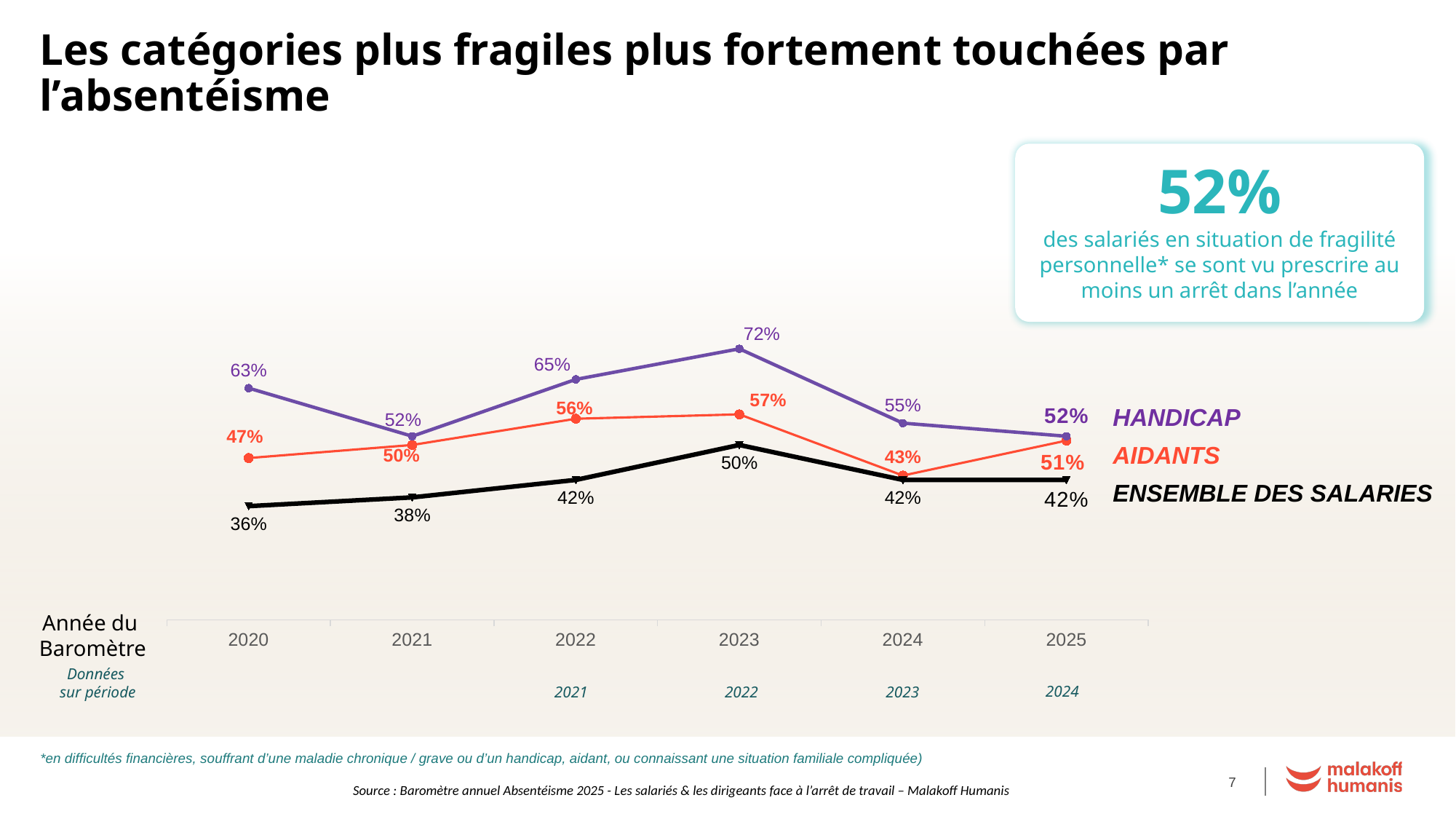
What is the value for AIDANTS in 2020? 47% Which is larger in 2021: the HANDICAP value or the AIDANTS value? HANDICAP How many years are shown on the x axis of the chart? 6 What is the difference between the HANDICAP value and the ENSEMBLE DES SALARIES value in 2023? 22 percentage points What is the value for ENSEMBLE DES SALARIES in 2023? 50% What is the value for HANDICAP in 2023? 72% How many series are plotted on the chart? 3 In which year is the ENSEMBLE DES SALARIES series at its lowest? 2020 What type of chart is shown on the slide? line chart Does the HANDICAP series rise or fall between 2023 and 2025? fall Which series is drawn in black on the chart? ENSEMBLE DES SALARIES In which year is the HANDICAP series at its highest? 2023